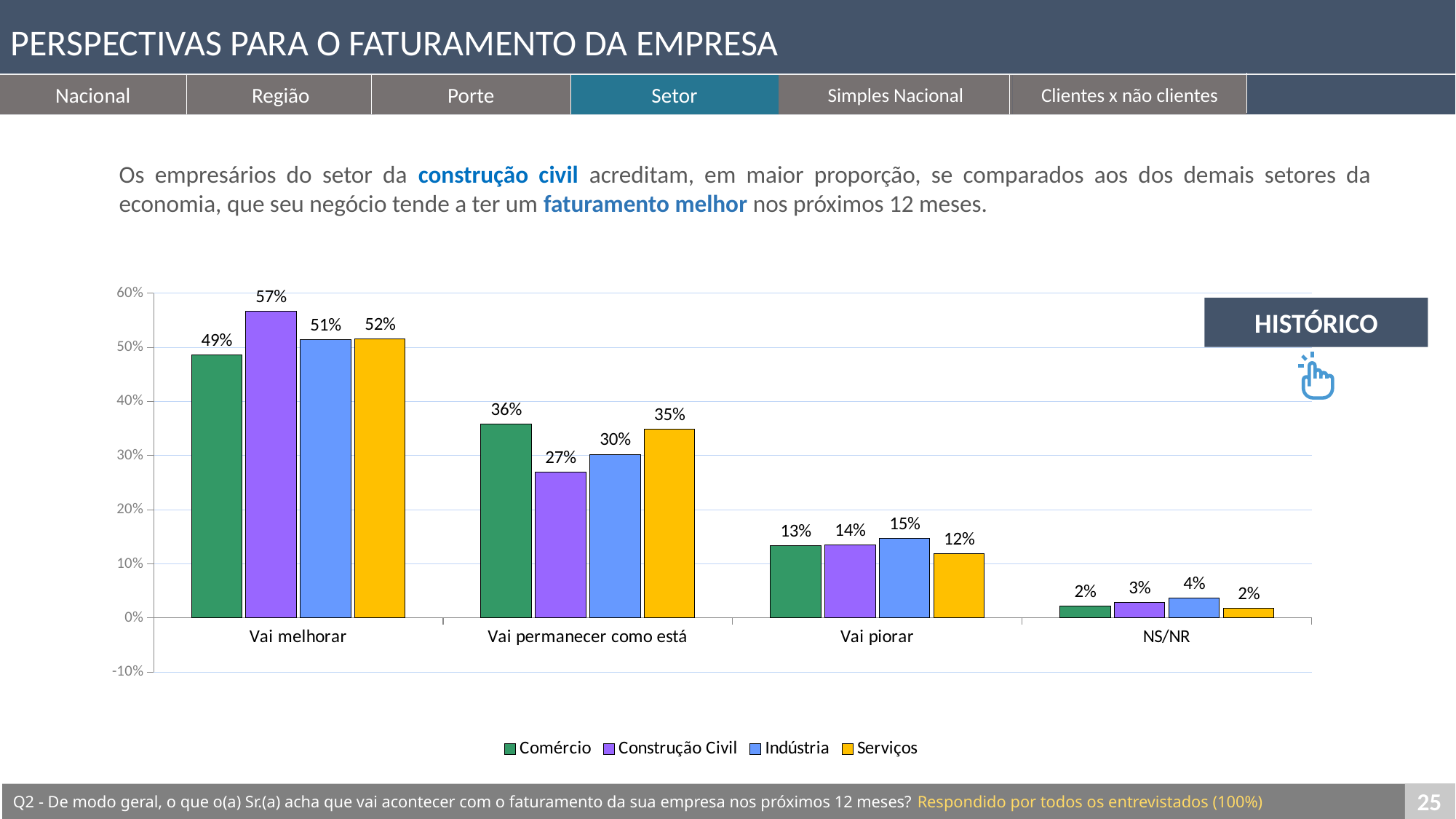
Which series has the highest value in the "Vai melhorar" category? Construção Civil What is the difference between the Comércio and Construção Civil values in the "Vai permanecer como está" category? 9% What is the value for Serviços in the "Vai permanecer como está" category? 35% Which colour represents Serviços in the chart? yellow Which series has the lowest value in the "Vai permanecer como está" category? Construção Civil What is the value for Indústria in the "Vai piorar" category? 15% How many categories are shown on the x axis? 4 Is the value for Comércio in the "Vai melhorar" category greater or less than 40%? greater What is the value for Construção Civil in the "Vai melhorar" category? 57% What kind of chart is shown on the slide? bar chart How many series does the legend list? 4 In the "Vai piorar" category, which is larger: the value for Indústria or the value for Serviços? Indústria